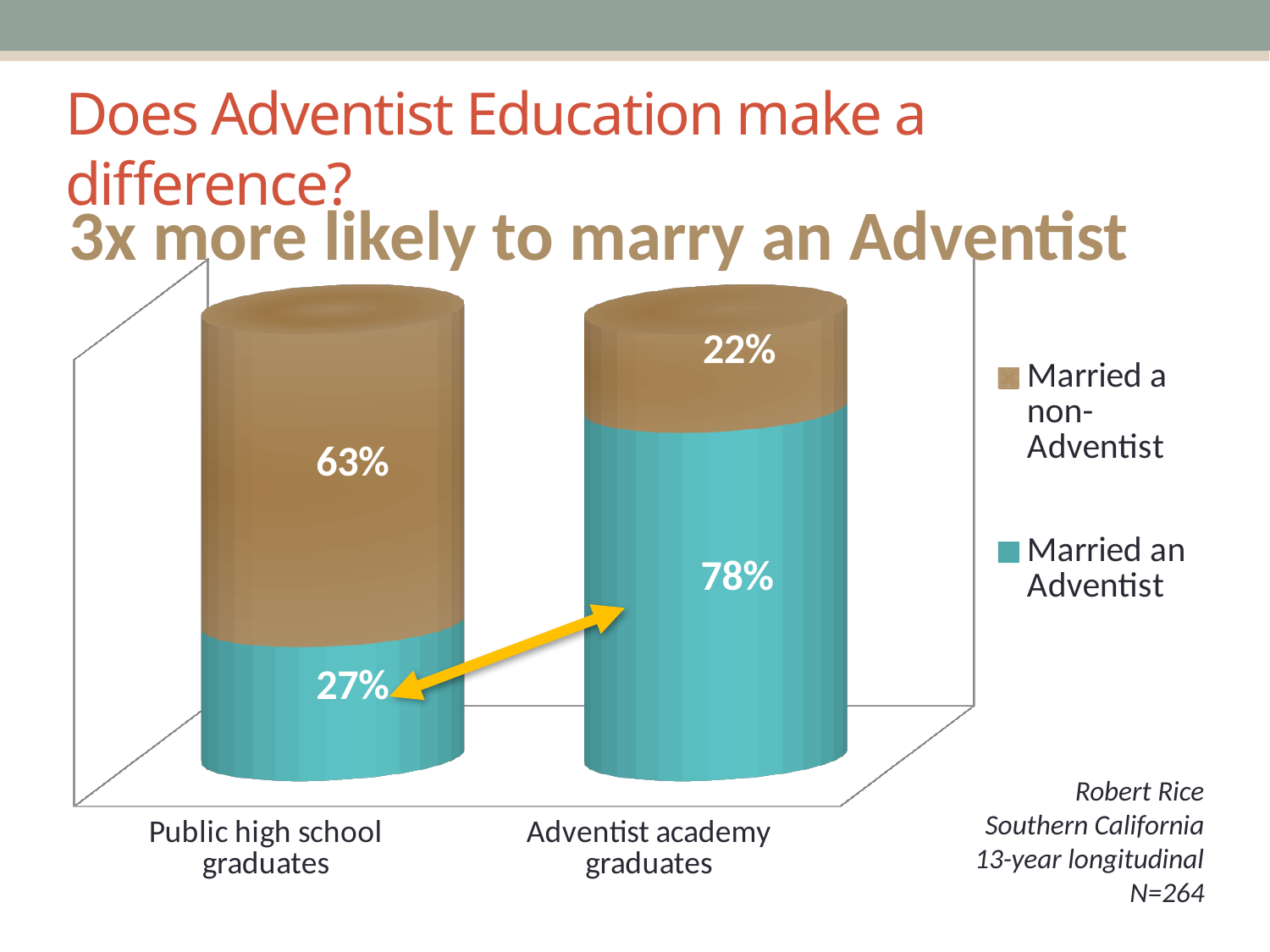
How many categories are shown on the x axis of the chart? 2 What percentage of Public high school graduates married a non-Adventist? 63% What percentage of Adventist academy graduates married an Adventist? 78% What kind of chart is shown on the slide? Stacked bar chart Which group has the higher percentage who married an Adventist? Adventist academy graduates What percentage of Adventist academy graduates married a non-Adventist? 22% Which group has the lower percentage who married a non-Adventist? Adventist academy graduates What is the total of the stacked bar for Adventist academy graduates? 100% What percentage of Public high school graduates married an Adventist? 27% What is the difference between the percentage of Adventist academy graduates and Public high school graduates who married an Adventist? 51% How many series does the chart legend list? 2 Is the 'Married a non-Adventist' value larger for Public high school graduates or Adventist academy graduates? Public high school graduates